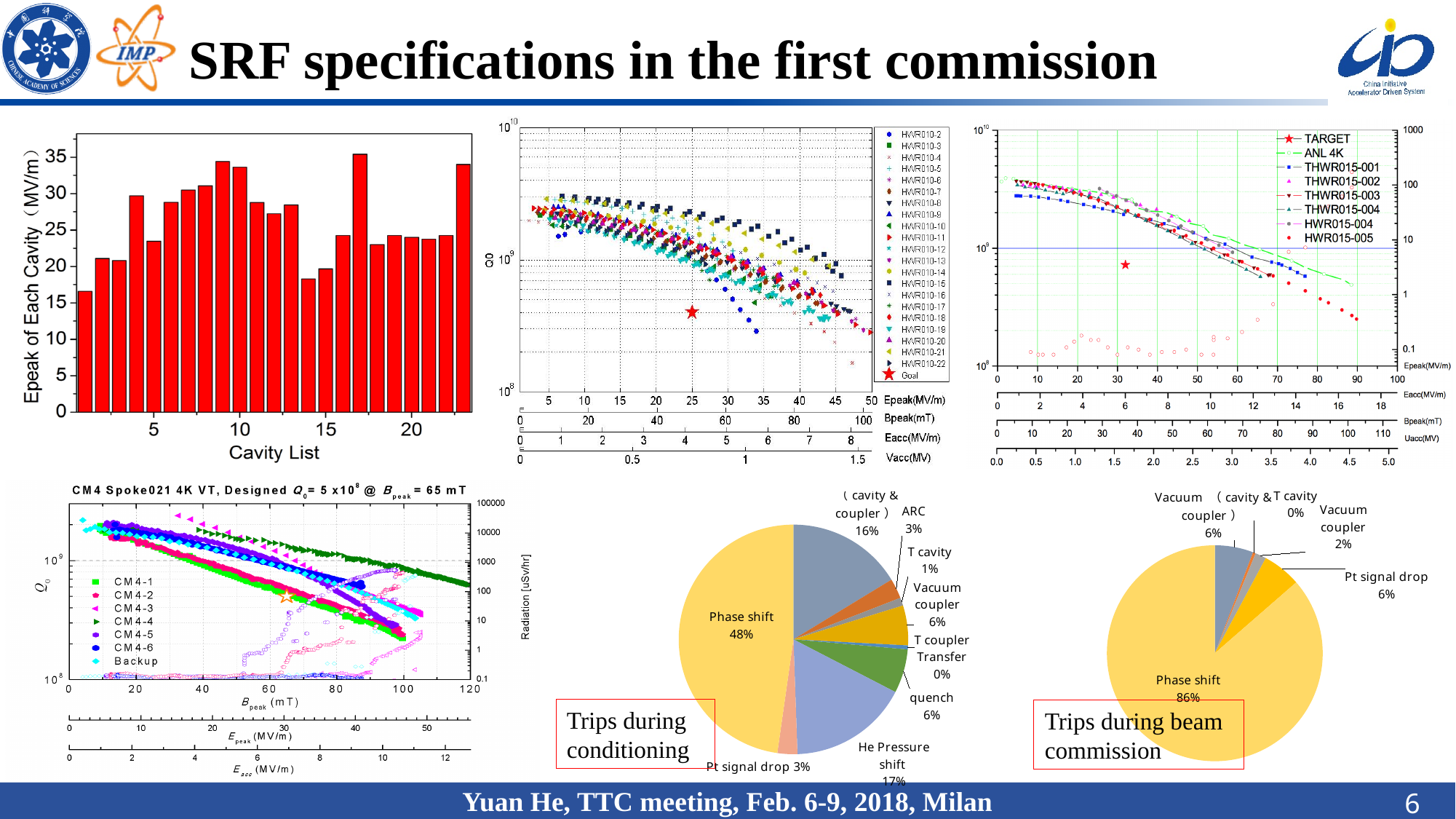
How many series does the legend of the 'CM4 Spoke021 4K VT' chart at the bottom left list? 7 In the 'Trips during conditioning' pie chart, what is the difference between the Phase shift share and the He Pressure shift share? 31% In the 'Trips during beam commission' pie chart, what share is Phase shift? 86% In the 'Trips during conditioning' pie chart, what share is He Pressure shift? 17% In the 'Trips during beam commission' pie chart, what share is T cavity? 0% In the 'Epeak of Each Cavity' chart at the top left, is the value for cavity 1 greater or less than 20? less In the 'Trips during beam commission' pie chart, what share is Pt signal drop? 6% Is the Phase shift share larger in the 'Trips during conditioning' pie chart or in the 'Trips during beam commission' pie chart? Trips during beam commission What kind of chart is the 'Epeak of Each Cavity' chart at the top left? bar chart In the 'Epeak of Each Cavity' chart at the top left, is the value for cavity 17 greater or less than 30? greater In the 'Trips during conditioning' pie chart, which category has the largest share? Phase shift In the 'Trips during conditioning' pie chart, what share is Phase shift? 48%